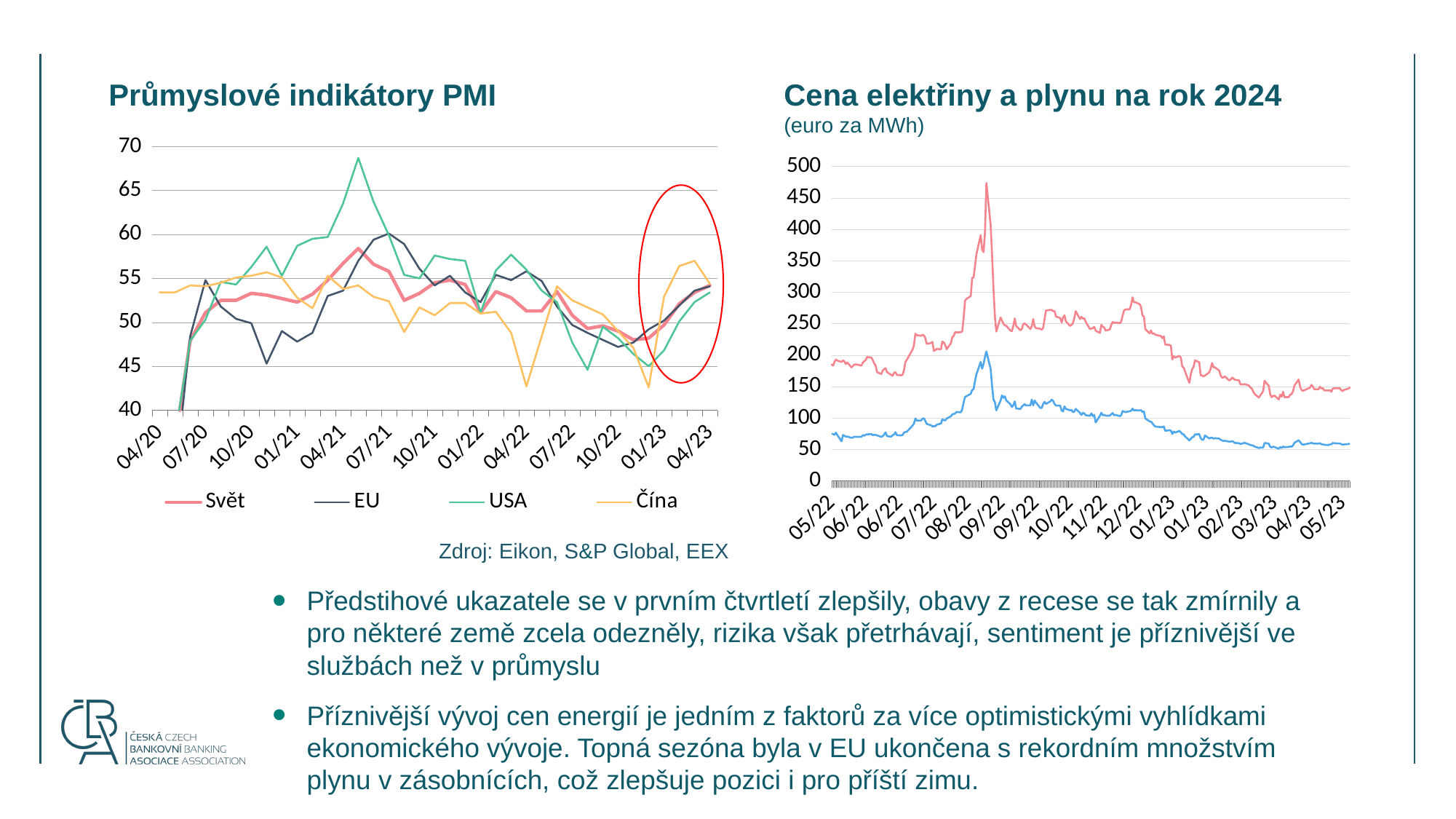
In the 'Cena elektřiny a plynu na rok 2024' chart, is the peak of the red line greater or less than 450? greater In the 'Průmyslové indikátory PMI' chart, is the highest value of the USA series greater or less than 65? greater How many series does the legend of the 'Průmyslové indikátory PMI' chart list? 4 In the 'Průmyslové indikátory PMI' chart, which series reaches the highest value over the whole period? USA In the 'Průmyslové indikátory PMI' chart, is the value of the Čína series at 04/23 greater or less than 50? greater In the 'Cena elektřiny a plynu na rok 2024' chart, do the values of the red line rise or fall between 12/22 and 05/23? fall In the 'Průmyslové indikátory PMI' chart, which series are listed in the legend? Svět, EU, USA, Čína What kind of chart is the 'Cena elektřiny a plynu na rok 2024' chart? line chart What unit is stated under the title of the 'Cena elektřiny a plynu na rok 2024' chart? euro za MWh What kind of chart is the 'Průmyslové indikátory PMI' chart? line chart